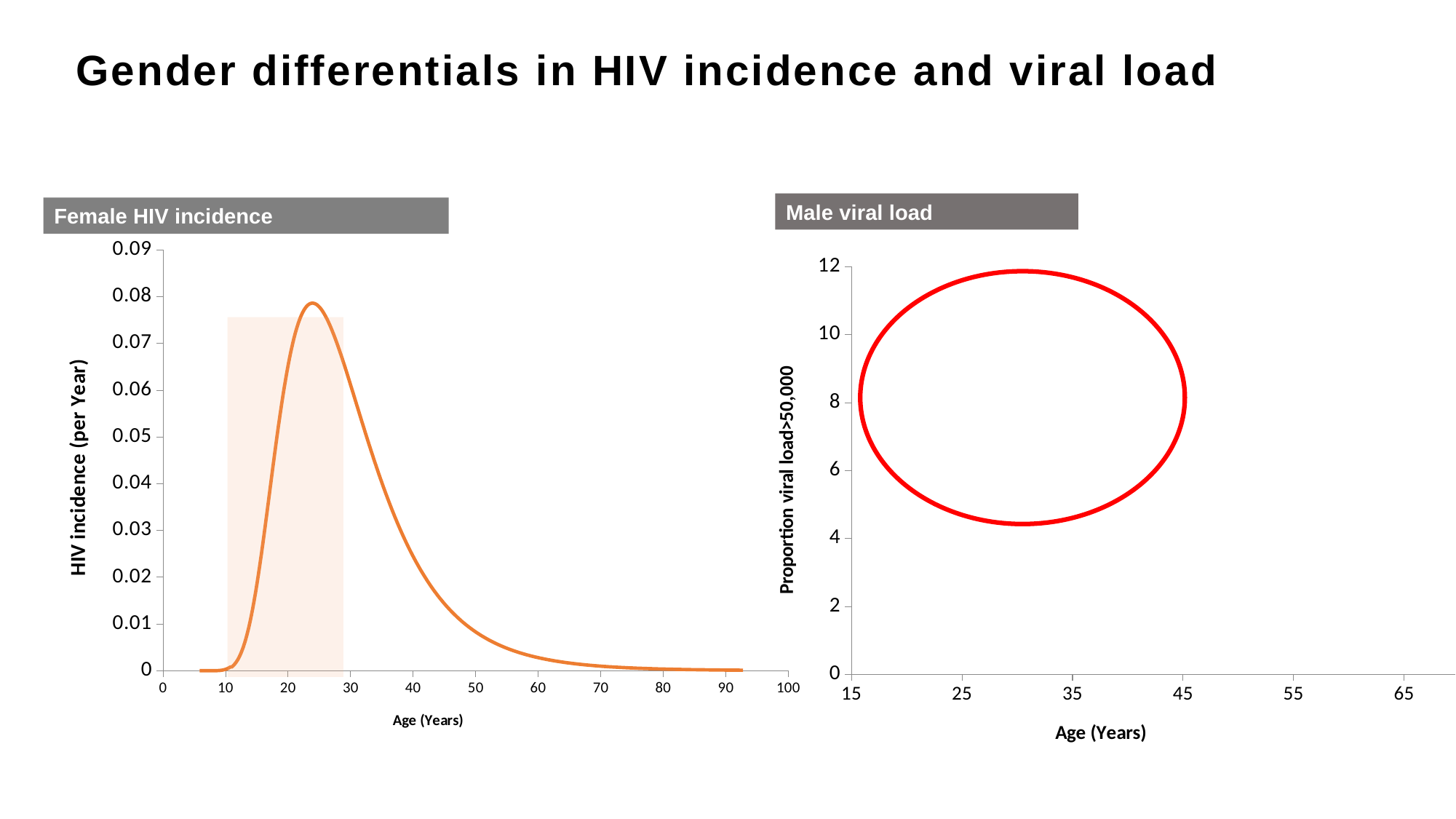
On the Female HIV incidence chart, which age has the higher HIV incidence, 30 or 50? 30 On the Female HIV incidence chart, do the values rise or fall as age increases from 10 to 20? rise On the Female HIV incidence chart, is the HIV incidence at age 60 greater or less than 0.01? less What kind of chart is the Female HIV incidence chart? line chart How many charts are shown on the slide? 2 What is the y-axis label of the Male viral load chart? Proportion viral load>50,000 What is the highest value shown on the y-axis of the Female HIV incidence chart? 0.09 On the Female HIV incidence chart, is the peak HIV incidence greater or less than 0.07? greater On the Female HIV incidence chart, is the HIV incidence at age 20 greater or less than 0.04? greater On the Female HIV incidence chart, which age has the higher HIV incidence, 20 or 40? 20 On the Female HIV incidence chart, do the values rise or fall as age increases from 30 to 90? fall